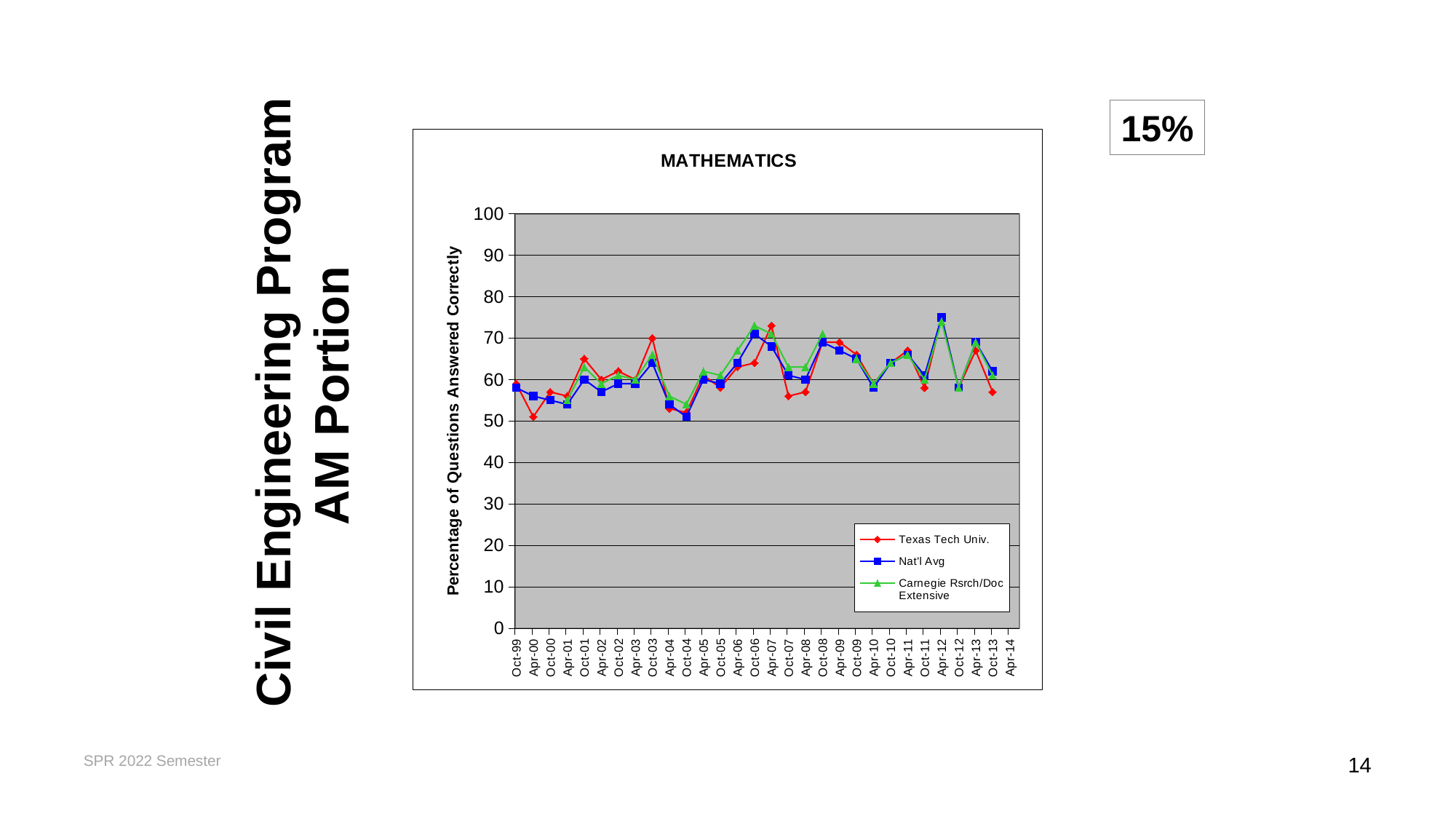
At which date does the Texas Tech Univ. series reach its lowest value? Apr-00 Is the value for Texas Tech Univ. at Apr-00 greater or less than 60? less How many series does the chart's legend list? 3 What type of chart is shown on the slide? Line chart At Oct-07, which is larger: the value for Texas Tech Univ. or the value for Nat'l Avg? Nat'l Avg At which date does the Nat'l Avg series reach its highest value? Apr-12 Is the value for Nat'l Avg at Apr-12 greater or less than 70? greater What is the label of the vertical axis of the chart? Percentage of Questions Answered Correctly What is the title of the chart? MATHEMATICS Is the value for Texas Tech Univ. at Oct-07 greater or less than 60? less